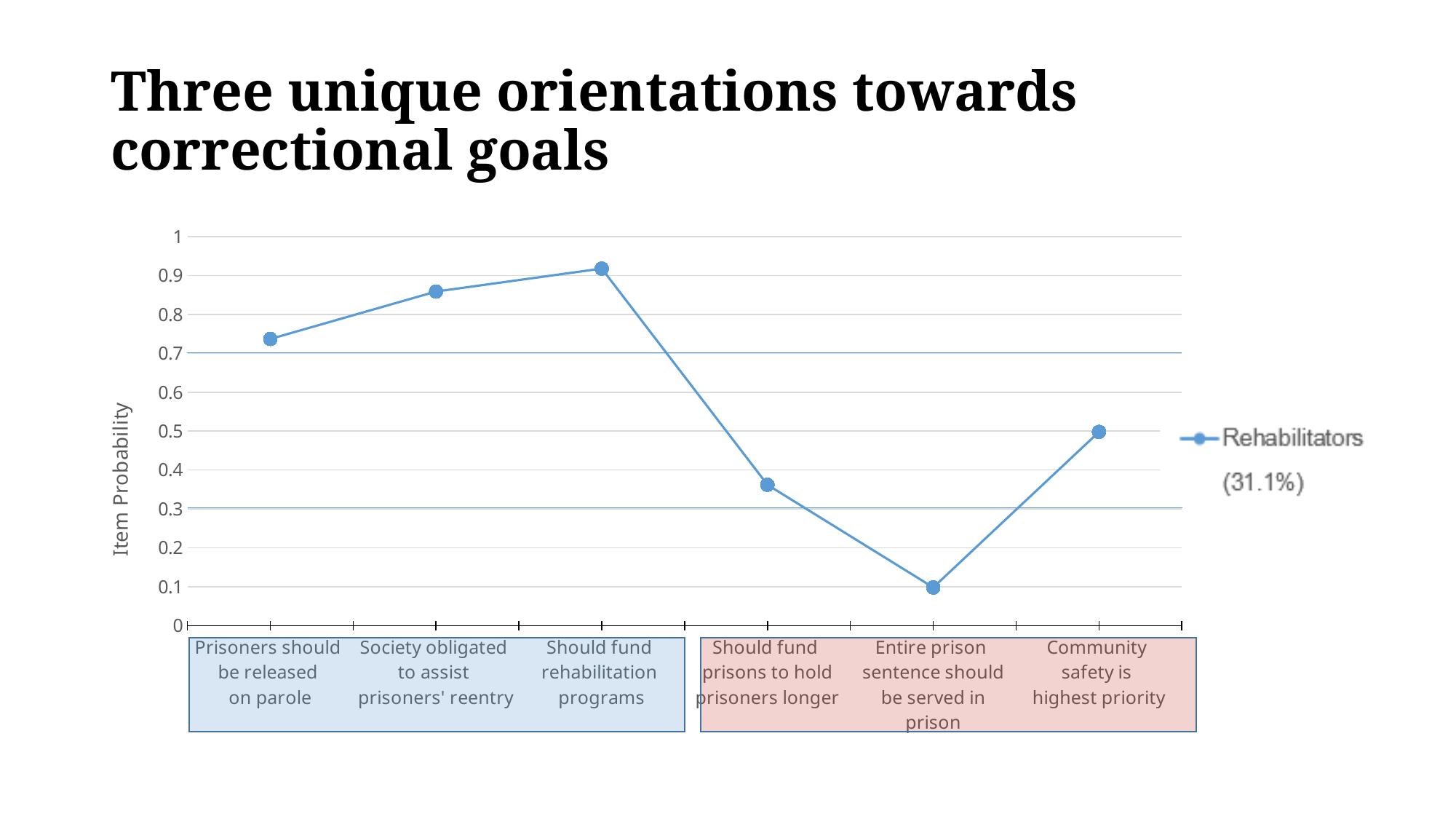
Is the value for 'Entire prison sentence should be served in prison' greater or less than 0.2? less Which has the larger item probability: 'Society obligated to assist prisoners' reentry' or 'Community safety is highest priority'? Society obligated to assist prisoners' reentry Is the value for 'Should fund prisons to hold prisoners longer' greater or less than 0.5? less What kind of chart is shown on the slide? line chart Is the value for 'Prisoners should be released on parole' greater or less than 0.6? greater How many series does the legend list? 1 Which category has the lowest item probability? Entire prison sentence should be served in prison Which category has the highest item probability? Should fund rehabilitation programs Do the values rise or fall from 'Should fund rehabilitation programs' to 'Entire prison sentence should be served in prison'? fall How many categories are plotted along the x axis? 6 What series name and percentage does the legend show? Rehabilitators (31.1%)